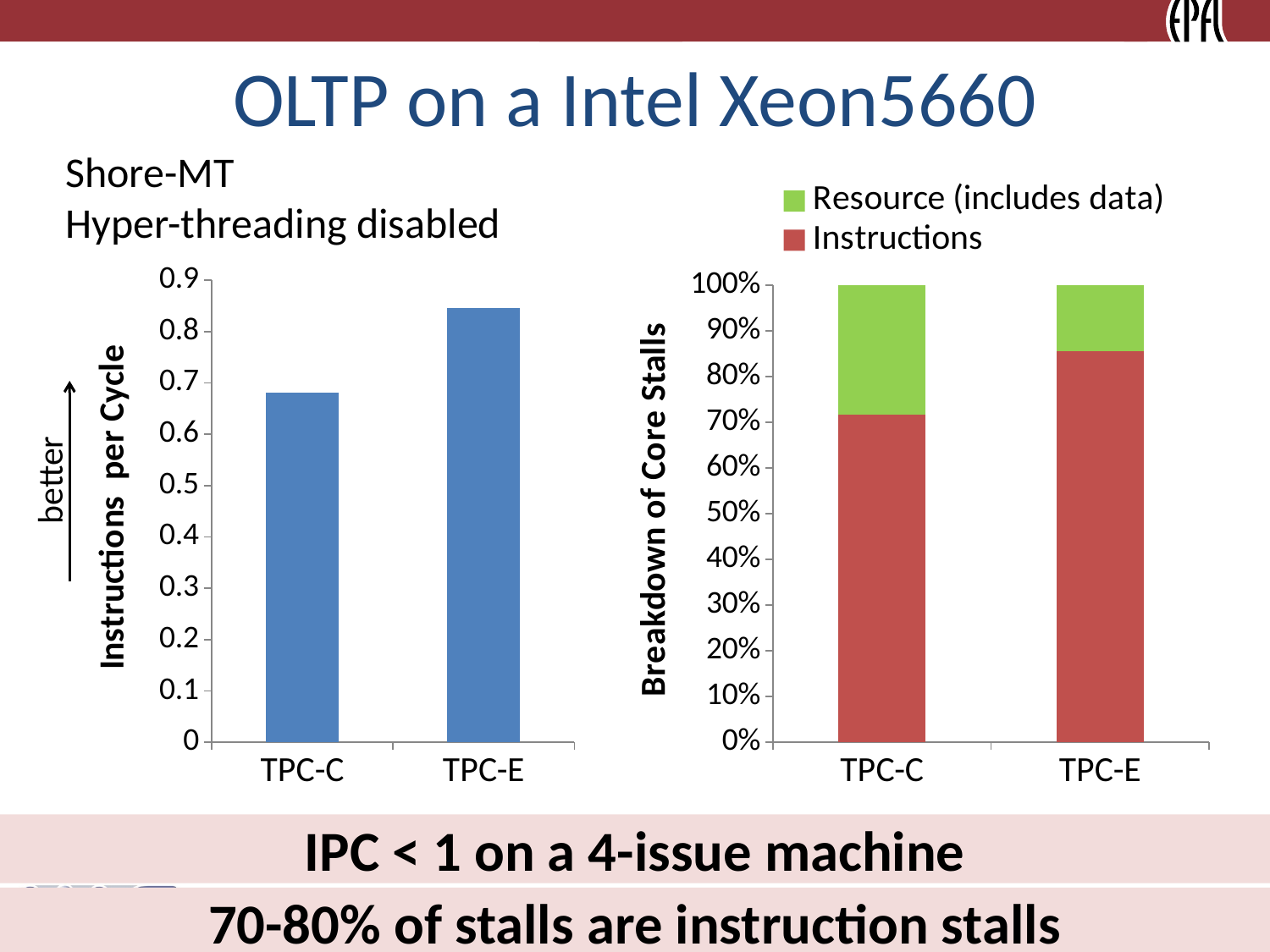
On the right chart (Breakdown of Core Stalls), is the Instructions share for TPC-E greater or less than 80%? greater On the left chart (Instructions per Cycle), is the value for TPC-E greater or less than 0.8? greater What kind of chart is the left chart (Instructions per Cycle)? bar chart On the right chart (Breakdown of Core Stalls), how many series does the legend list? 2 On the left chart (Instructions per Cycle), which category has the lowest value? TPC-C On the right chart (Breakdown of Core Stalls), which series is shown in green? Resource (includes data) On the left chart (Instructions per Cycle), is the value for TPC-C greater or less than 0.7? less What is the y-axis title of the right chart? Breakdown of Core Stalls On the right chart (Breakdown of Core Stalls), which category has the larger Instructions share, TPC-C or TPC-E? TPC-E How many categories are shown on the left chart (Instructions per Cycle)? 2 On the left chart (Instructions per Cycle), which category has the higher value, TPC-C or TPC-E? TPC-E